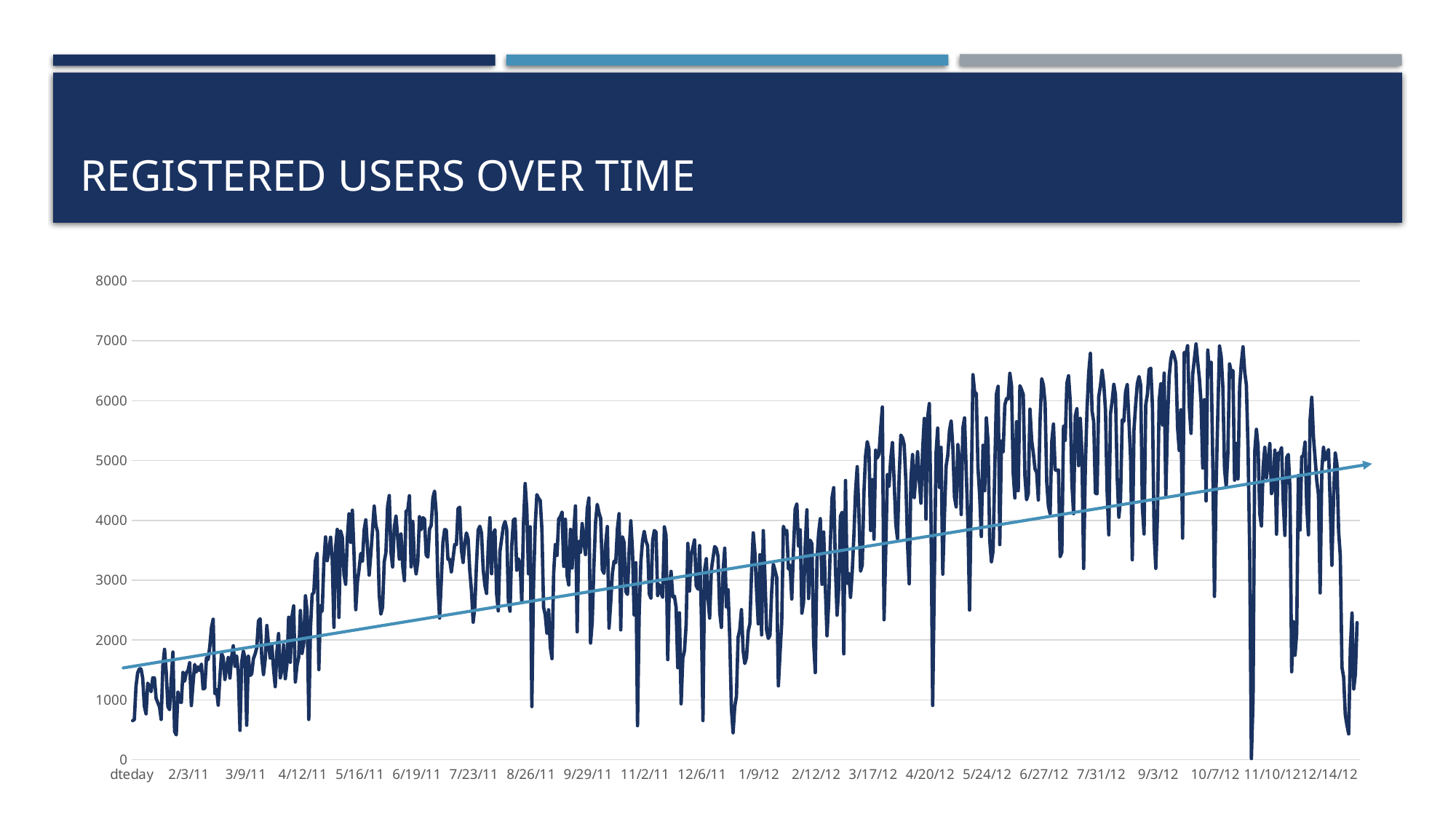
What is the highest value shown on the y axis? 8000 What is the title of the chart? Registered Users Over Time Overall, do the values rise or fall from the start of the x axis to the end? rise Is the value around 7/31/12 greater or less than 2000? greater Is the value around 2/3/11 greater or less than 3000? less Are the values around 9/3/12 higher or lower than the values around 3/9/11? higher What is the last date label shown on the x axis? 12/14/12 What kind of chart is shown on the slide? line chart Is the lowest point of the line greater or less than 1000? less Does the blue trend arrow slope upward or downward? upward